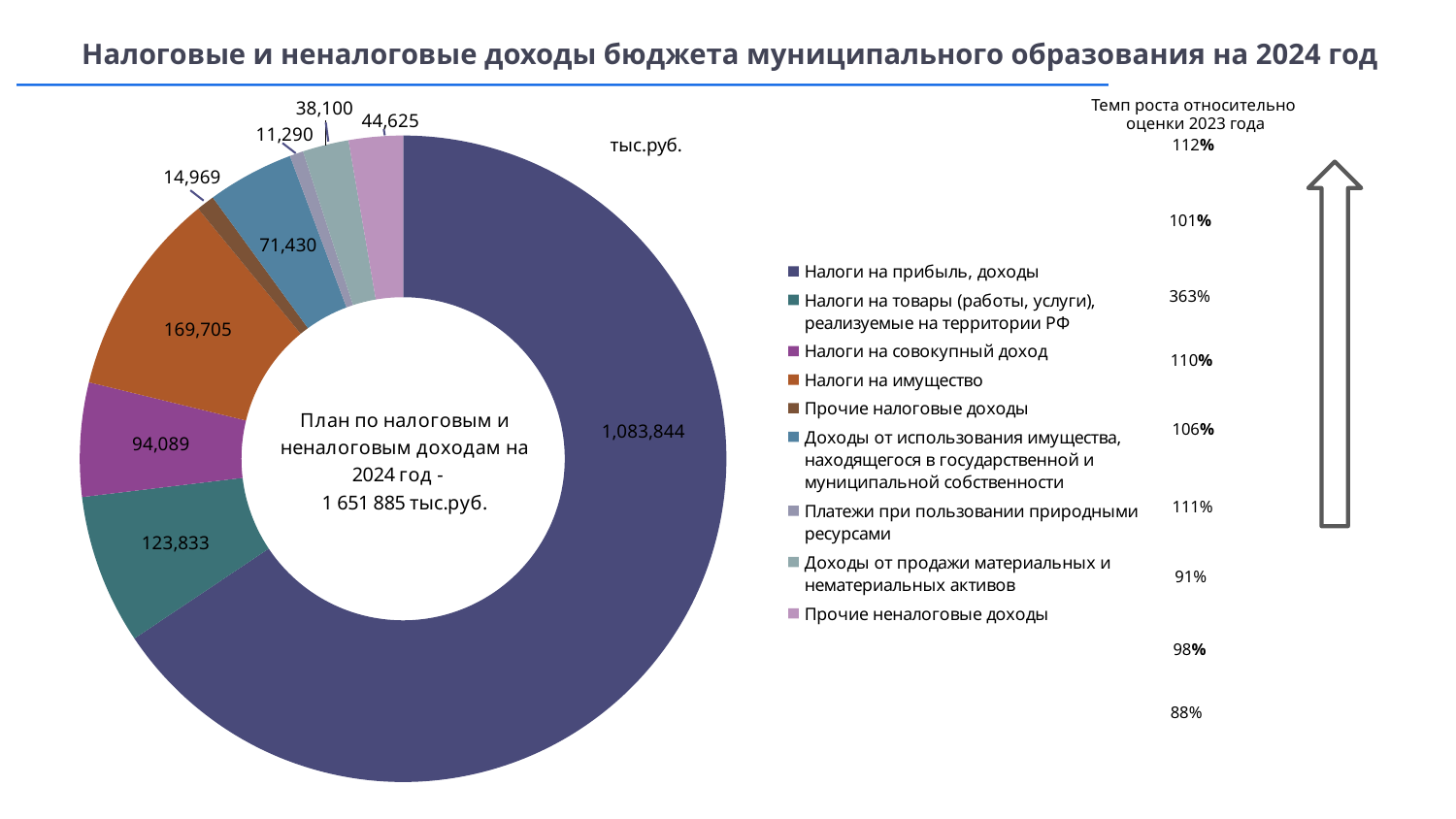
What is the difference between Налоги на имущество and Налоги на товары (работы, услуги), реализуемые на территории РФ? 45,872 What unit is stated for the values in the chart? тыс.руб. What kind of chart is shown on the slide? doughnut chart How many categories does the chart show? 9 Which category has the largest value? Налоги на прибыль, доходы What is the value for Доходы от использования имущества, находящегося в государственной и муниципальной собственности? 71,430 What is the value for Налоги на прибыль, доходы? 1,083,844 What is the total of all values shown in the chart, as stated in its centre? 1 651 885 тыс.руб. Which category has the smallest value? Платежи при пользовании природными ресурсами What is the value for Налоги на имущество? 169,705 Which is larger: Налоги на совокупный доход or Налоги на товары (работы, услуги), реализуемые на территории РФ? Налоги на товары (работы, услуги), реализуемые на территории РФ What is the value for Прочие неналоговые доходы? 44,625